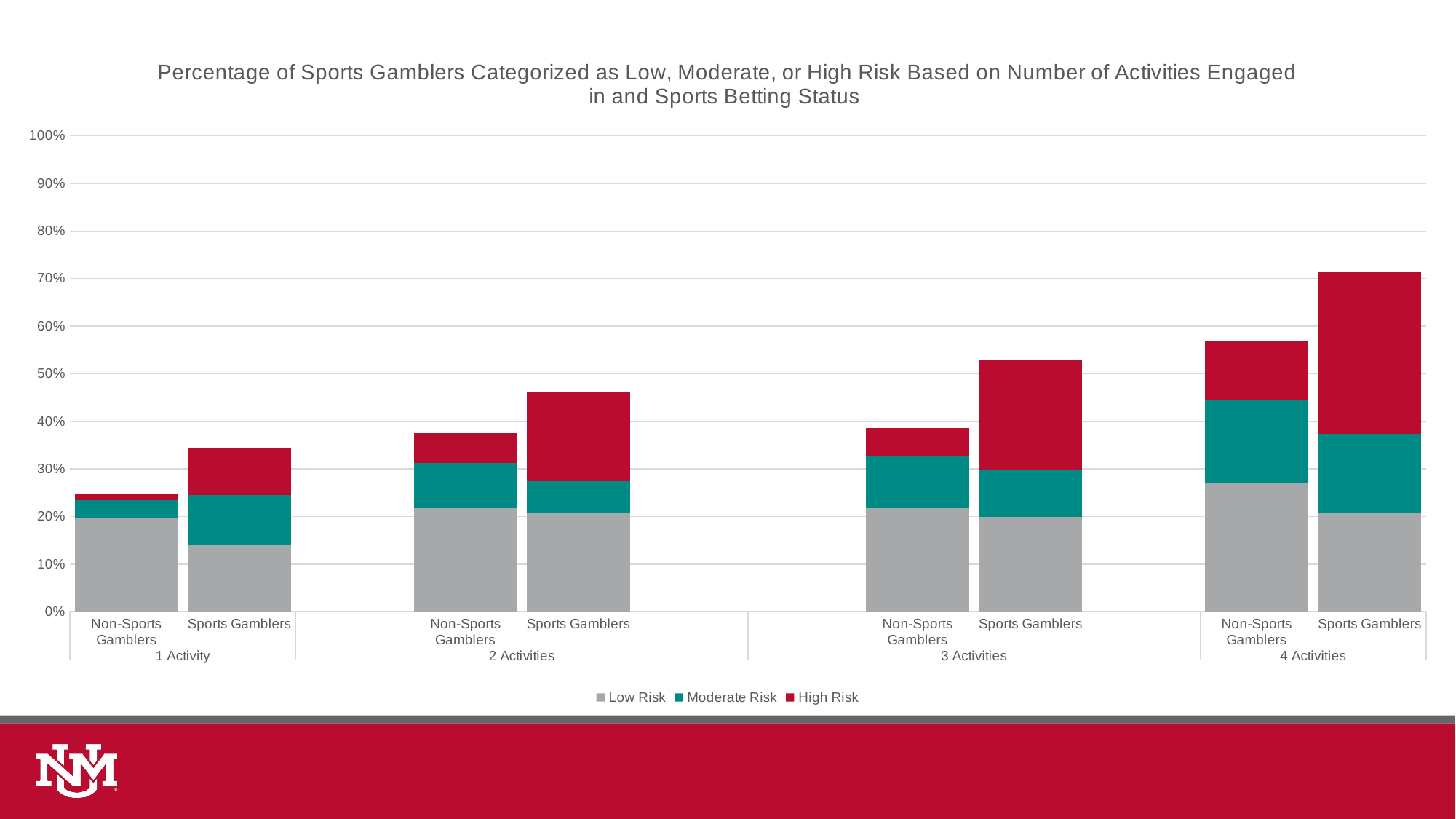
Is the total for Sports Gamblers with 4 Activities greater or less than 60%? greater Is the total for Sports Gamblers with 2 Activities greater or less than 40%? greater What are the three risk categories listed in the legend? Low Risk, Moderate Risk, High Risk Within the 3 Activities group, which bar has the larger total: Non-Sports Gamblers or Sports Gamblers? Sports Gamblers Is the total for Non-Sports Gamblers with 1 Activity greater or less than 30%? less How many bars are plotted in the chart? 8 For Sports Gamblers, do the total percentages rise or fall as the number of activities increases from 1 to 4? rise Which bar has the highest total percentage? Sports Gamblers, 4 Activities How many activity groups are shown along the x axis? 4 How many series does the legend list? 3 Which bar has the lowest total percentage? Non-Sports Gamblers, 1 Activity What kind of chart is shown on the slide? Stacked bar chart